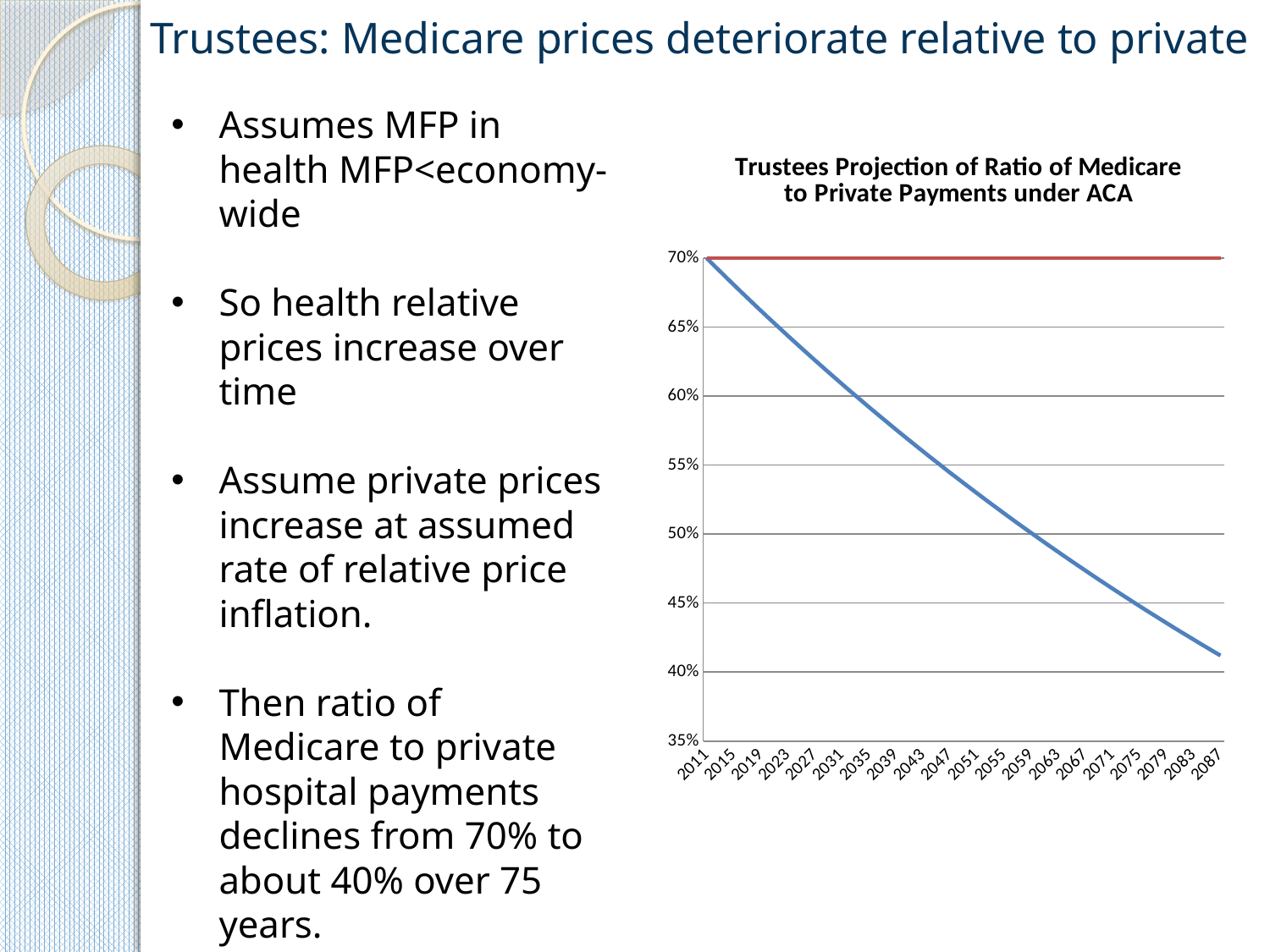
Is the value of the blue line in 2087 greater or less than 45%? less Does the blue line rise or fall as the years increase along the x axis? fall Is the value of the blue line in 2043 greater or less than 55%? greater What is the title of the chart? Trustees Projection of Ratio of Medicare to Private Payments under ACA What kind of chart is shown on the slide? line chart Is the value of the blue line in 2087 greater or less than 40%? greater What value does the blue line start at in 2011? 70% At what value does the flat red line sit across the whole chart? 70% In 2087, which line is higher, the red line or the blue line? the red line What is the lowest value shown on the y axis? 35% How many year labels are shown along the x axis? 20